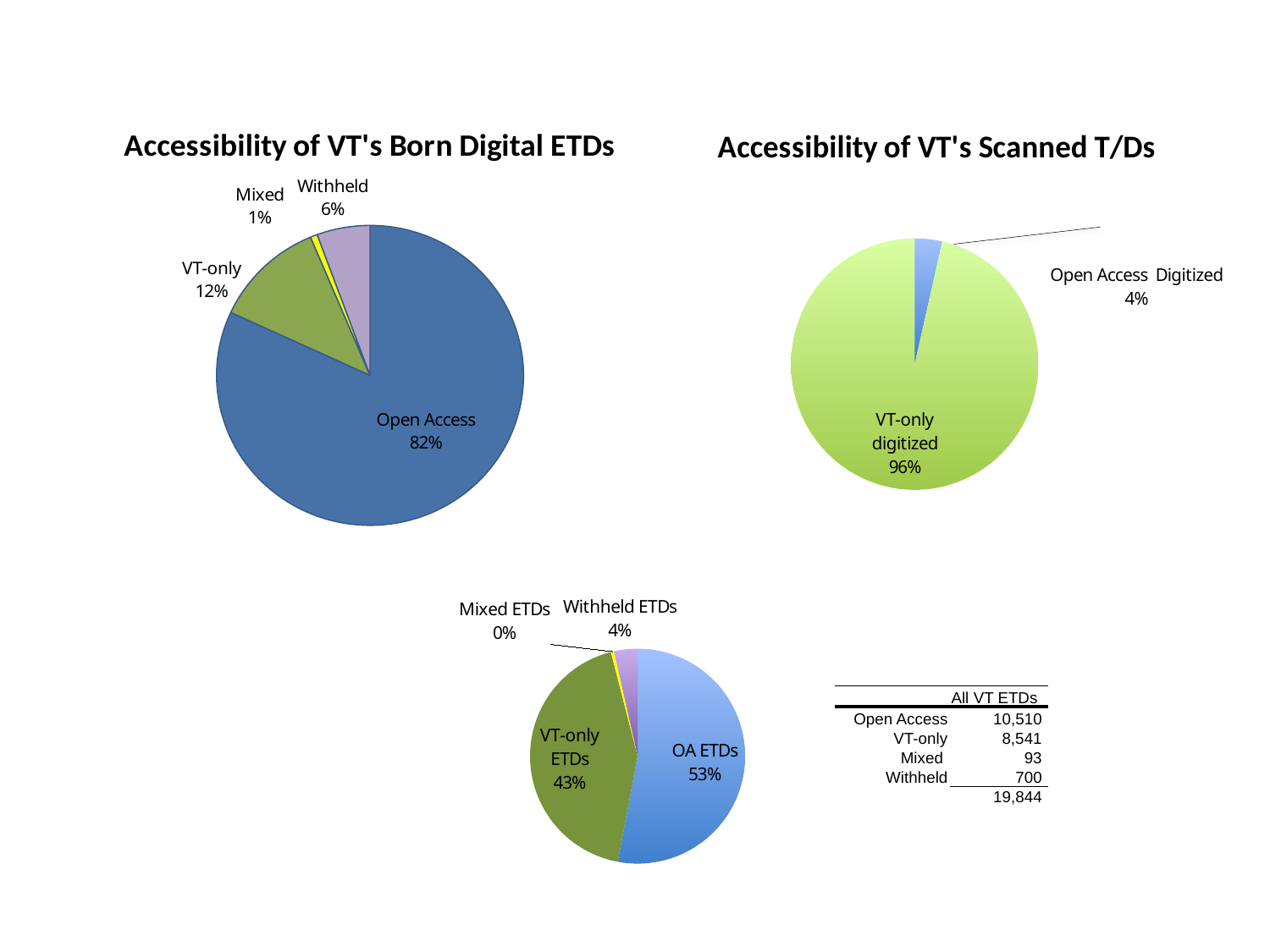
In the 'Accessibility of VT's Born Digital ETDs' chart, what is the difference between the Withheld and Mixed percentages? 5% In the 'Accessibility of VT's Scanned T/Ds' chart, what percentage is VT-only digitized? 96% In the bottom pie chart, what percentage is Withheld ETDs? 4% In the bottom pie chart, which is larger, OA ETDs or VT-only ETDs? OA ETDs In the 'Accessibility of VT's Born Digital ETDs' chart, which category has the smallest slice? Mixed What kind of chart is 'Accessibility of VT's Scanned T/Ds'? Pie chart In the bottom pie chart, what is the difference between OA ETDs and VT-only ETDs? 10% In the 'Accessibility of VT's Scanned T/Ds' chart, what share of the pie is Open Access Digitized? 4% In the 'Accessibility of VT's Born Digital ETDs' chart, what percentage is VT-only? 12% In the 'Accessibility of VT's Born Digital ETDs' chart, what share of the pie is Open Access? 82% In the bottom pie chart, what percentage is OA ETDs? 53% In the 'Accessibility of VT's Born Digital ETDs' chart, how many slices does the pie have? 4